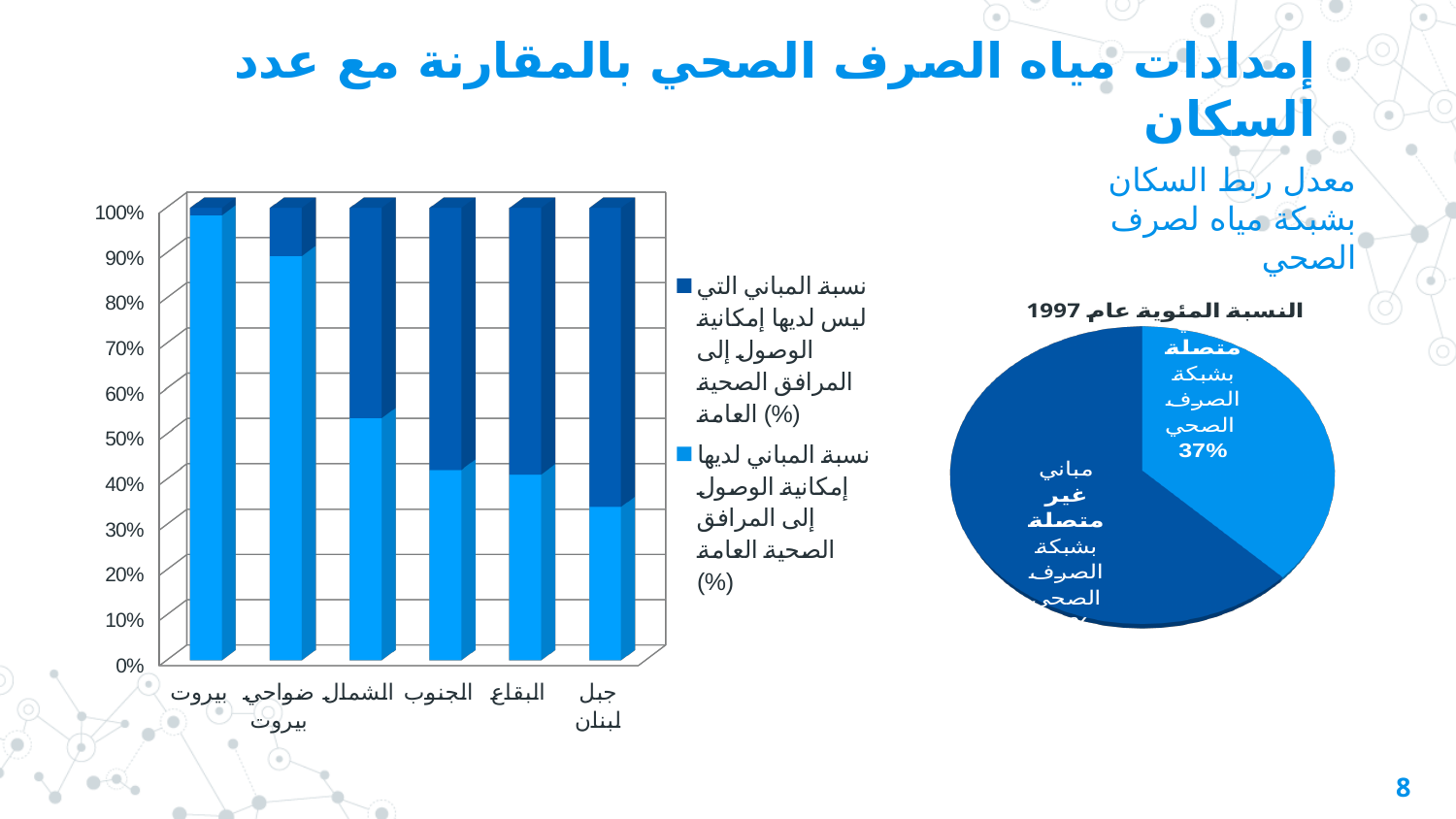
In the bar chart on the left, is the value for بيروت in the series نسبة المباني لديها إمكانية الوصول إلى المرافق الصحية العامة (%) greater or less than 90%? greater In the bar chart on the left, which category has the lowest value for the series نسبة المباني لديها إمكانية الوصول إلى المرافق الصحية العامة (%)? جبل لبنان What type of chart is the chart on the left side of the slide? bar chart What is the title of the pie chart on the right side of the slide? النسبة المئوية عام 1997 In the pie chart titled النسبة المئوية عام 1997, what share is shown for the slice متصلة بشبكة الصرف الصحي? 37% How many series does the legend of the bar chart on the left list? 2 How many categories are shown on the x axis of the bar chart on the left? 6 In the bar chart on the left, which category has the highest value for the series نسبة المباني لديها إمكانية الوصول إلى المرافق الصحية العامة (%)? بيروت In the bar chart on the left, is the value for جبل لبنان in the series نسبة المباني لديها إمكانية الوصول إلى المرافق الصحية العامة (%) greater or less than 40%? less In the bar chart on the left, is the value for الشمال in the series نسبة المباني التي ليس لديها إمكانية الوصول إلى المرافق الصحية العامة (%) greater or less than 40%? greater What type of chart is the chart titled النسبة المئوية عام 1997? pie chart In the bar chart on the left, which is larger for the series نسبة المباني لديها إمكانية الوصول إلى المرافق الصحية العامة (%): the value for الشمال or the value for جبل لبنان? الشمال